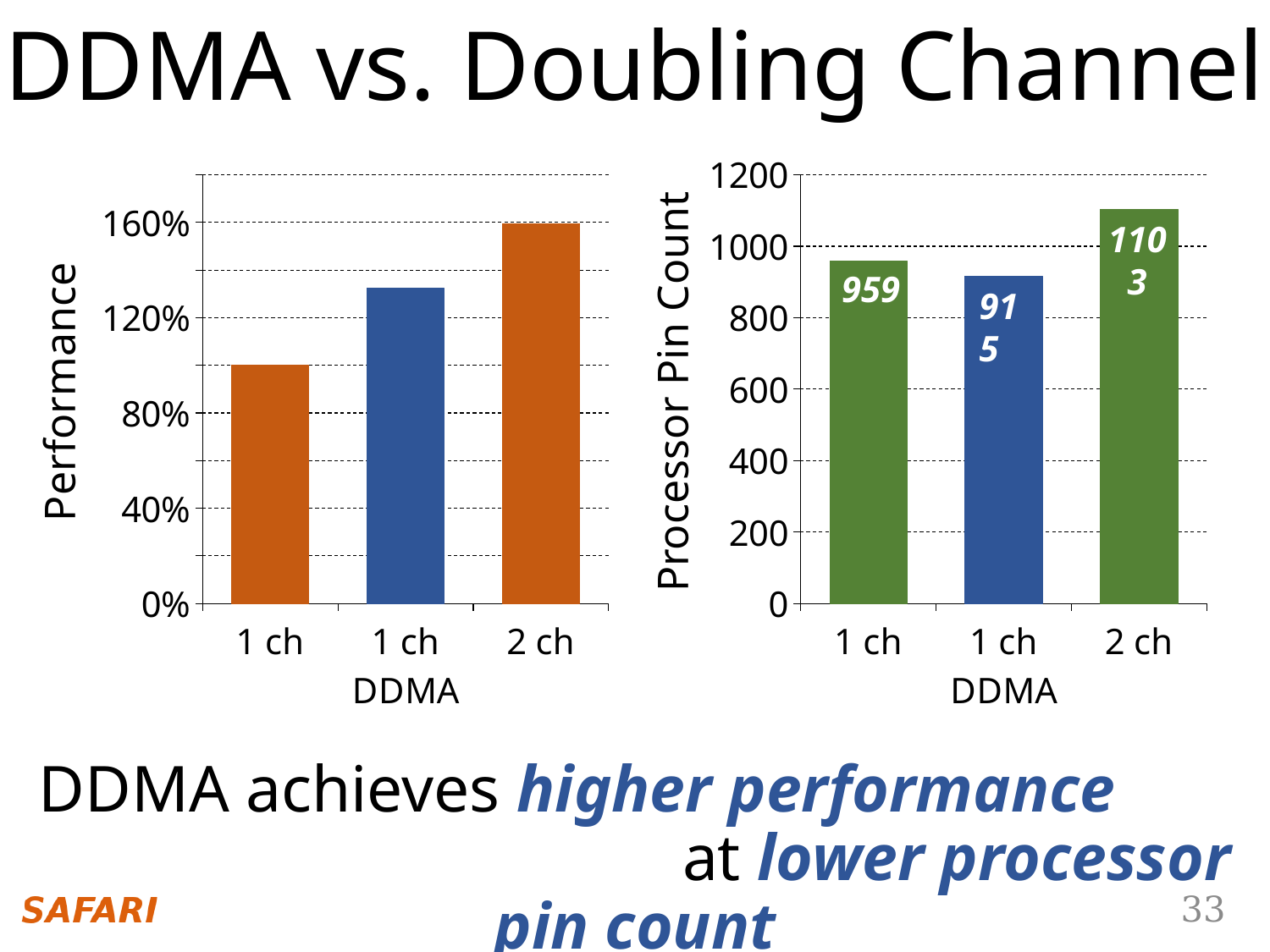
In the Processor Pin Count chart, how many more pins does 1 ch have than 1 ch DDMA? 44 In the Processor Pin Count chart, which configuration has the highest pin count? 2 ch In the Performance chart, is the value for 1 ch DDMA greater or less than 120%? greater In the Processor Pin Count chart, what is the processor pin count for 1 ch? 959 In the Processor Pin Count chart, what is the difference in pin count between 2 ch and 1 ch DDMA? 188 In the Processor Pin Count chart, which configuration has the lowest pin count? 1 ch DDMA In the Processor Pin Count chart, what is the processor pin count for 1 ch DDMA? 915 What type of chart is the Processor Pin Count chart? Bar chart In the Performance chart, is the value for 1 ch greater or less than 120%? less In the Processor Pin Count chart, what is the processor pin count for 2 ch? 1103 In the Performance chart, which has higher performance, 2 ch or 1 ch DDMA? 2 ch How many bars are shown in the Performance chart? 3